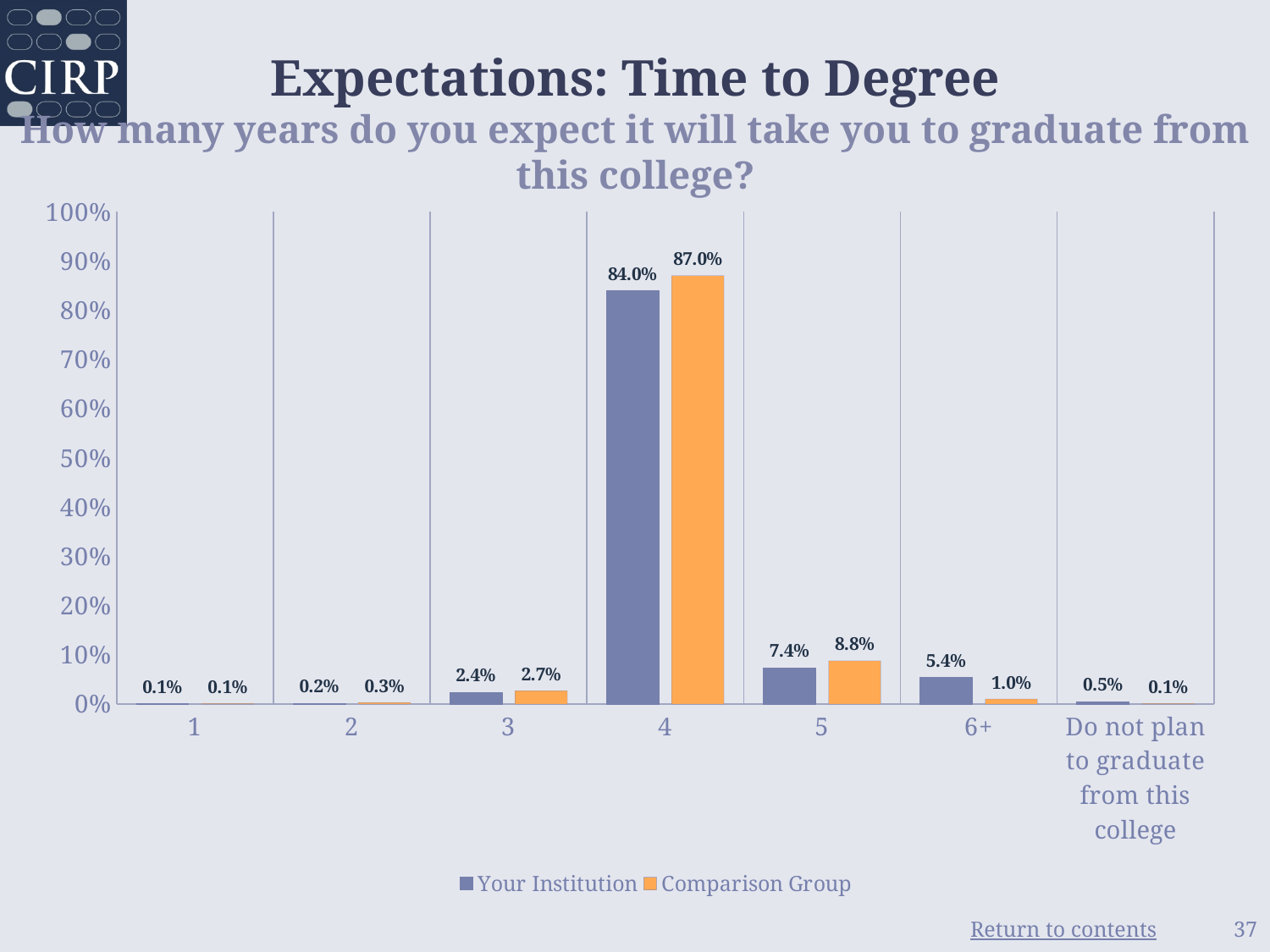
What kind of chart is shown on the slide? Bar chart Is the value for Your Institution in the 4 years category greater or less than 80%? greater What is the value for Your Institution in the 4 years category? 84.0% What is the difference between Comparison Group and Your Institution in the 4 years category? 3.0% What is the value for Comparison Group in the 5 years category? 8.8% How many categories are shown on the x axis? 7 Which is larger in the 3 years category, Your Institution or Comparison Group? Comparison Group What is the difference between Your Institution and Comparison Group in the 6+ years category? 4.4% Which category has the highest value for Comparison Group? 4 What is the value for Your Institution in the 6+ years category? 5.4% How many series does the legend list? 2 What is the value for Comparison Group in the 'Do not plan to graduate from this college' category? 0.1%